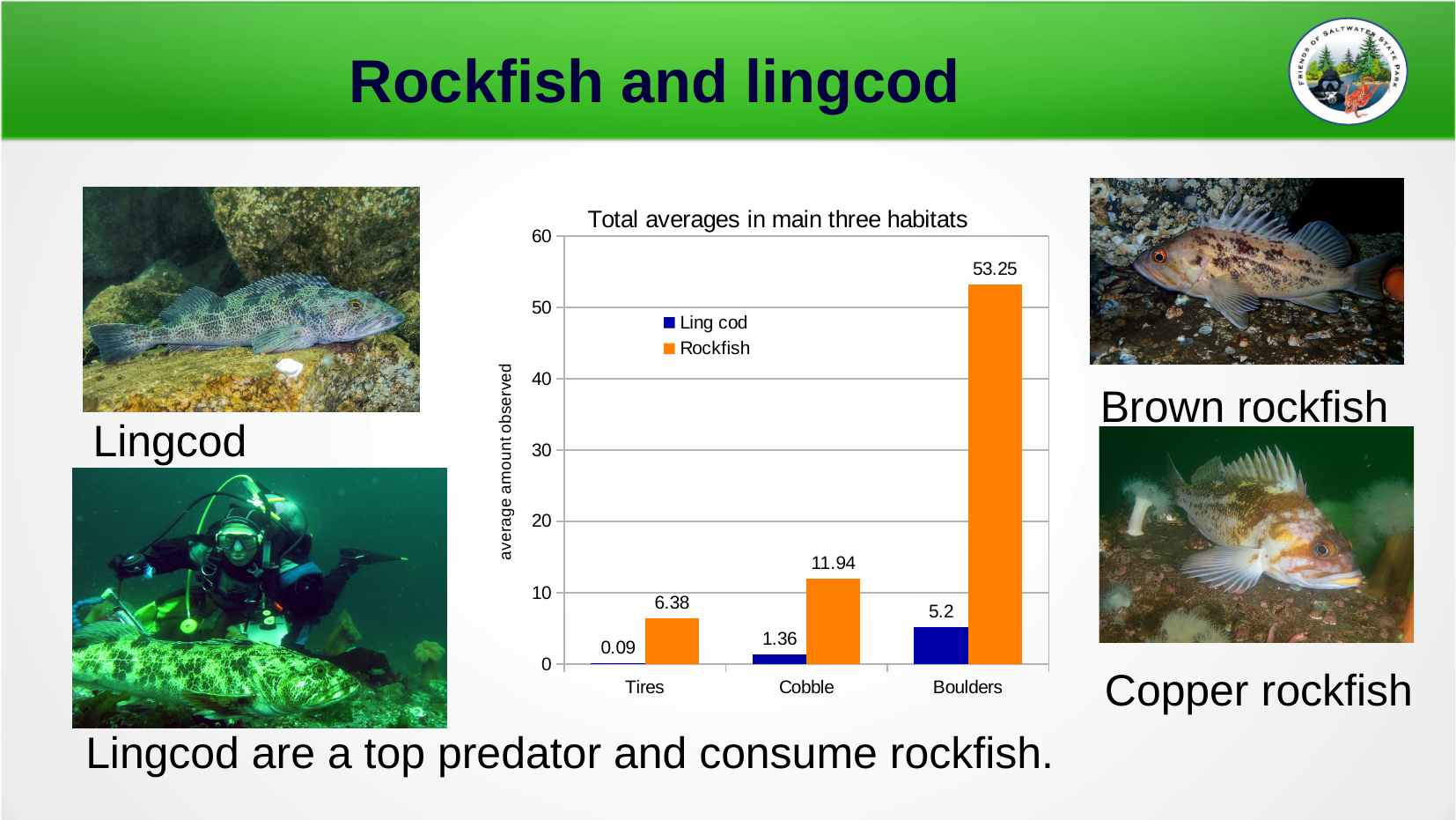
What is the Rockfish value for Boulders? 53.25 Is the Rockfish value for Boulders greater or less than 50? greater What is the difference between the Rockfish and Ling cod values for Boulders? 48.05 What is the Ling cod value for Boulders? 5.2 Which is larger, the Rockfish value for Tires or the Ling cod value for Boulders? Rockfish value for Tires Which habitat has the highest Rockfish value? Boulders How many habitat categories are shown on the x axis? 3 What is the Rockfish value for Cobble? 11.94 What is the title of the chart? Total averages in main three habitats How many series does the legend list? 2 Which habitat has the lowest Ling cod value? Tires What is the Ling cod value for Tires? 0.09